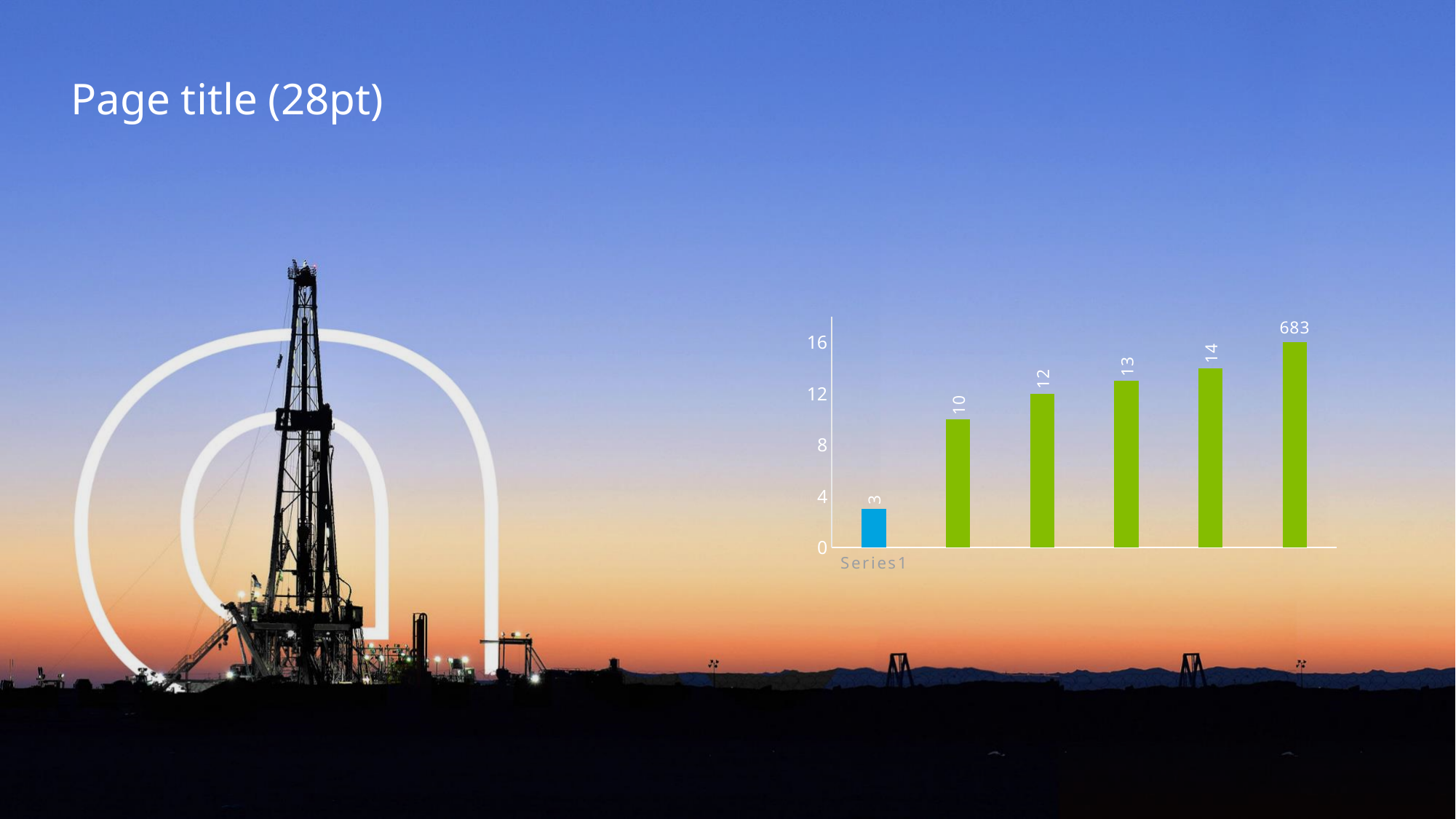
Which is larger, the value for Series1 or the value of the third bar from the left? the third bar from the left What is the value shown for Series1? 3 Which bar has the lowest value in the chart? Series1 How many bars are plotted in the chart? 6 What is the data label on the second bar from the left? 10 What is the difference between the second bar from the left (10) and Series1 (3)? 7 What is the data label printed above the rightmost bar? 683 Do the bar values rise or fall from left to right across the chart? rise What is the highest tick value shown on the vertical axis? 16 What is the data label on the fourth bar from the left? 13 What colour is the Series1 bar? blue What type of chart is shown on the slide? bar chart